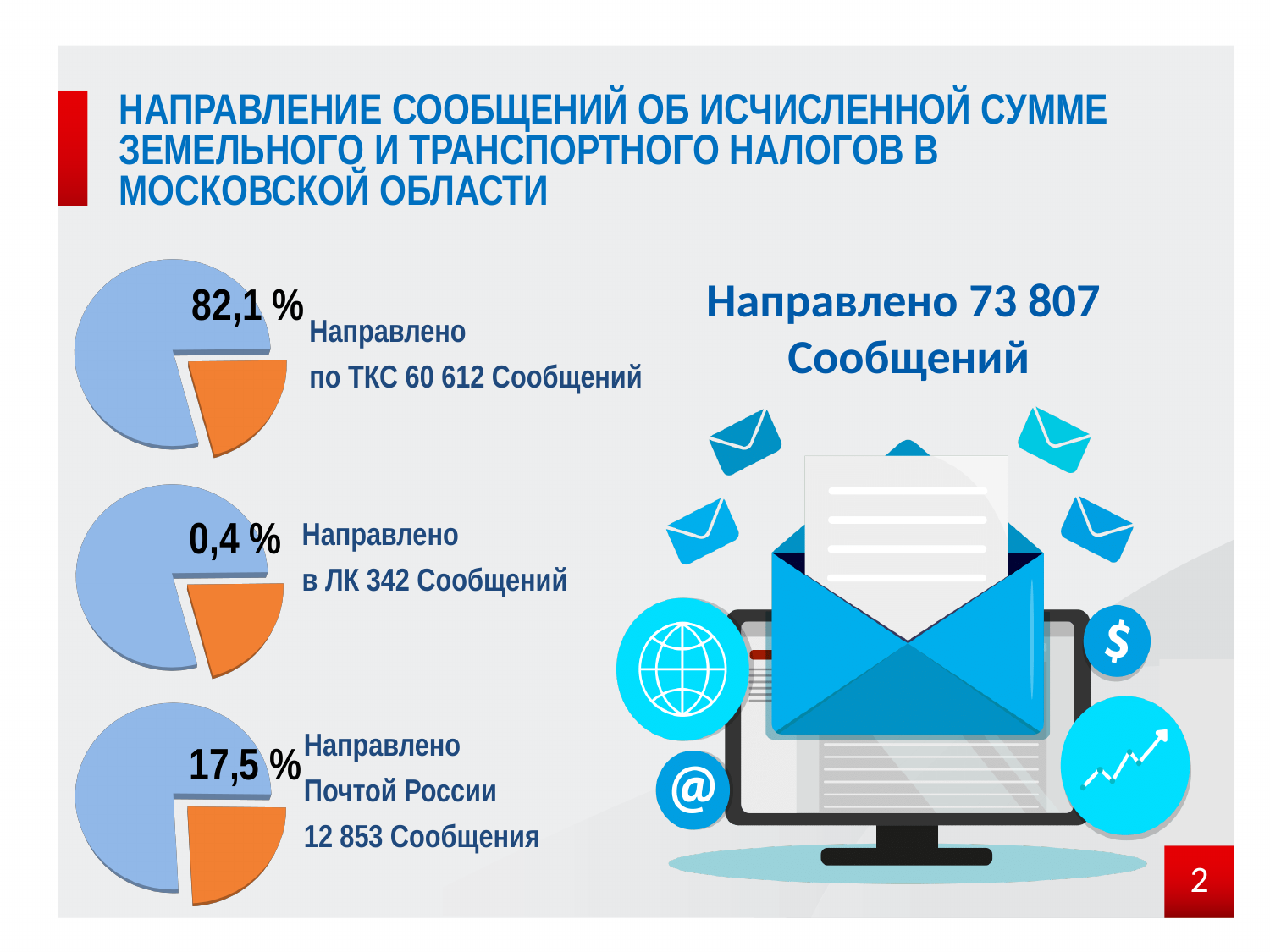
How many messages were sent via ТКС according to the top pie chart's label? 60 612 What is the difference in the number of messages between ТКС (60 612) and Почта России (12 853)? 47 759 Which is larger: the share of messages sent by Почта России or the share sent to ЛК? Почта России How many messages were sent by Почта России according to the bottom pie chart's label? 12 853 Which delivery channel has the lowest percentage of messages among the three pie charts? в ЛК What percentage is shown on the bottom pie chart (messages sent by Почта России)? 17,5 % What is the total number of messages sent, as stated on the slide? 73 807 What percentage is shown on the middle pie chart (messages sent to ЛК)? 0,4 % Which delivery channel has the highest percentage of messages among the three pie charts? по ТКС What percentage is shown on the top pie chart (messages sent via ТКС)? 82,1 % What type of charts are shown on the left side of the slide? Pie charts How many messages were sent to ЛК according to the middle pie chart's label? 342